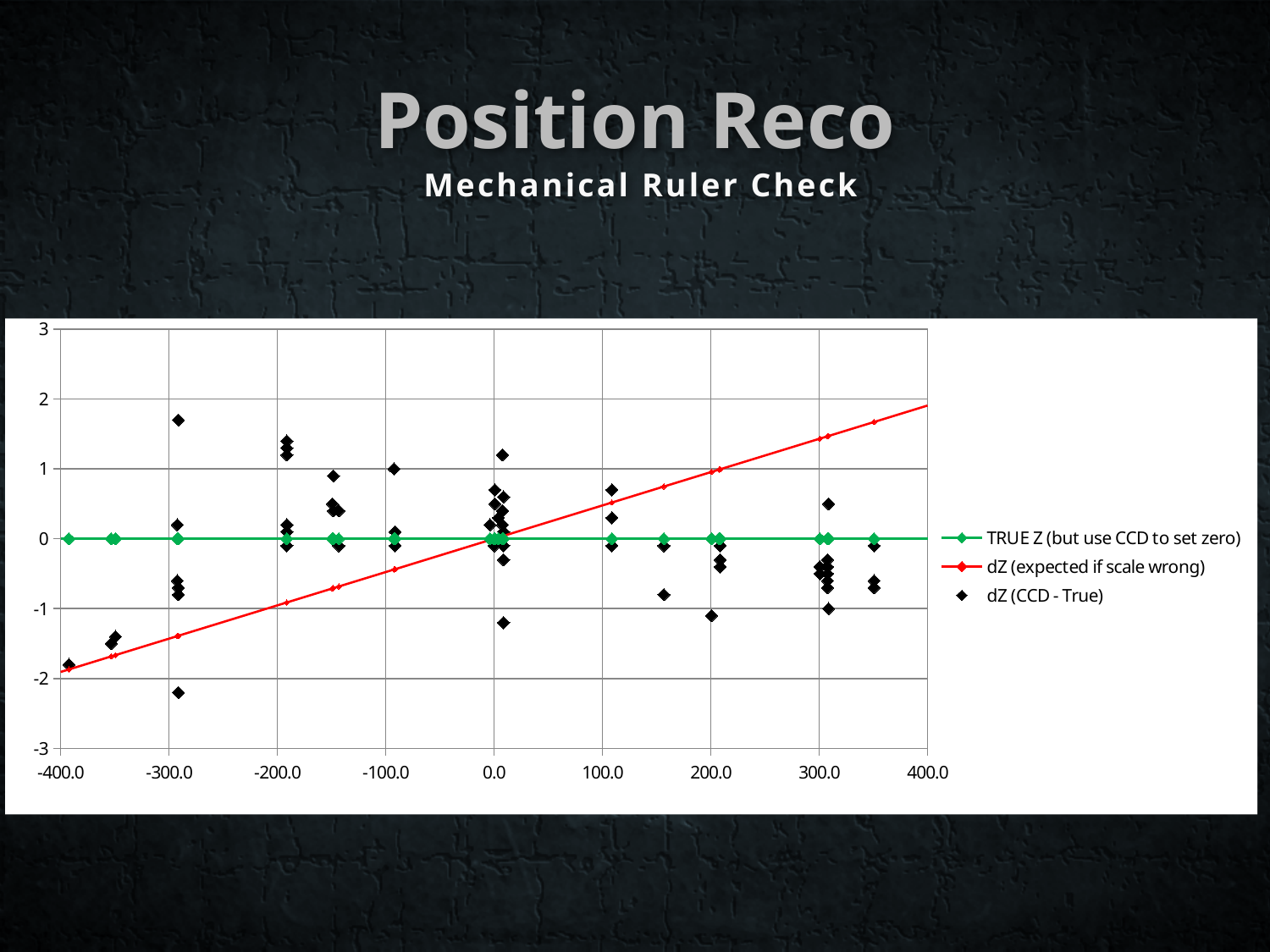
Is the value of the red 'dZ (expected if scale wrong)' line at x = -400.0 greater or less than -1? less Which series in the legend is drawn in red? dZ (expected if scale wrong) Does the red 'dZ (expected if scale wrong)' line rise or fall as x increases from -400 to 400? rise What kind of chart is shown on the slide? scatter chart How many series does the chart's legend list? 3 Is the lowest black 'dZ (CCD - True)' point near x = -300.0 greater or less than -2? less Which series in the legend is drawn in green? TRUE Z (but use CCD to set zero) Is the value of the green 'TRUE Z' line at x = 0.0 greater or less than 1? less At x = -400.0, which is larger: the green 'TRUE Z' line or the red 'dZ (expected if scale wrong)' line? TRUE Z (but use CCD to set zero) At x = 400.0, which is larger: the red 'dZ (expected if scale wrong)' line or the green 'TRUE Z' line? dZ (expected if scale wrong)